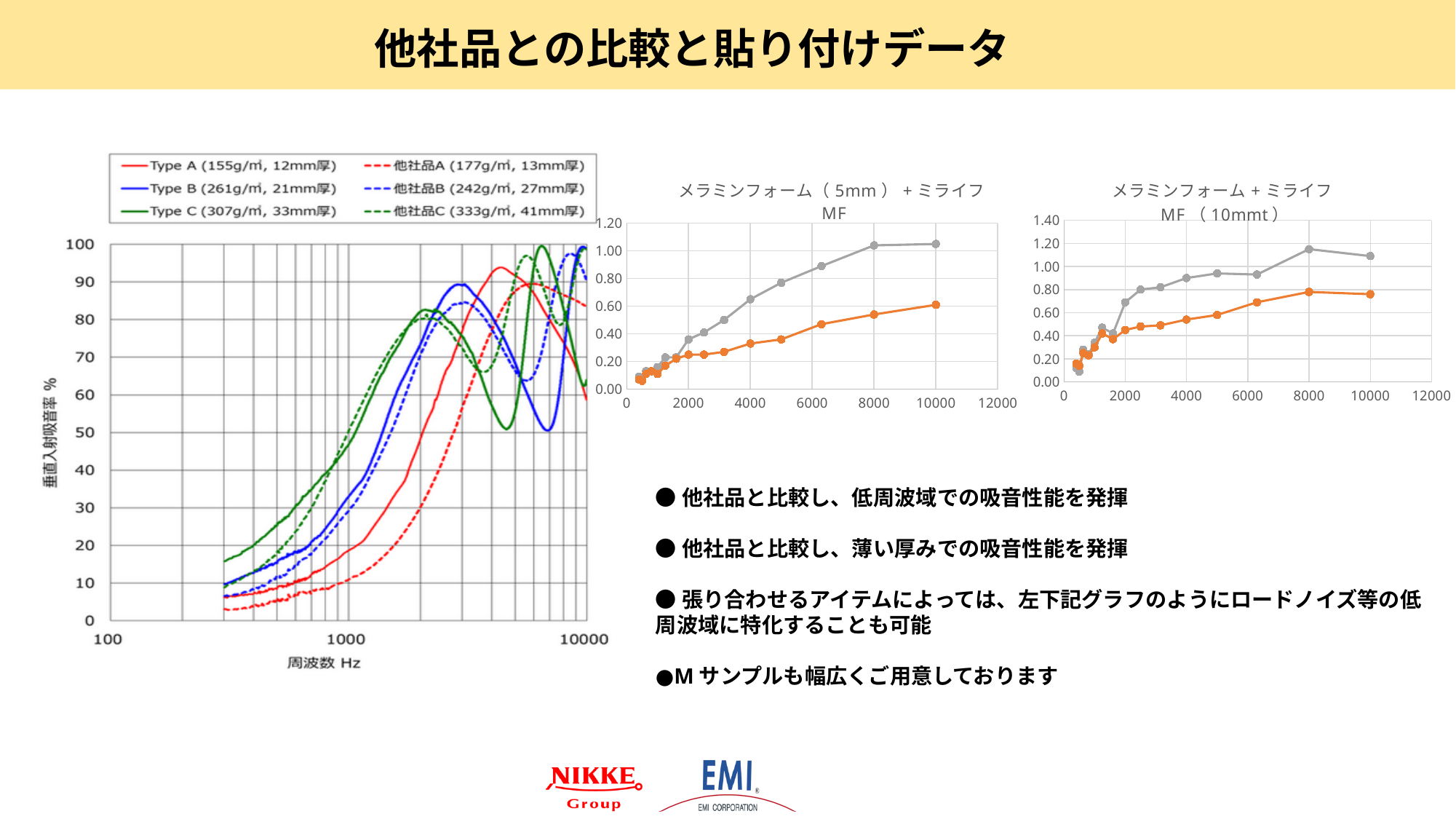
In the chart titled メラミンフォーム（5mm）+ミライフMF, is the value of the orange line at 10000 greater or less than 0.80? less How many series does the legend of the left chart list? 6 In the left chart, which series is drawn as a solid green line? Type C (307g/㎡, 33mm厚) In the chart titled メラミンフォーム（5mm）+ミライフMF, is the value of the gray line at 10000 greater or less than 1.00? greater In the chart titled メラミンフォーム+ミライフMF（10mmt）, do the values of the gray line generally rise or fall as the x axis increases? rise In the chart titled メラミンフォーム（5mm）+ミライフMF, which line has the larger value at 8000, the gray line or the orange line? the gray line In the chart titled メラミンフォーム+ミライフMF（10mmt）, is the value of the gray line at 8000 greater or less than 1.00? greater What kind of chart is the chart titled メラミンフォーム（5mm）+ミライフMF? line chart What kind of chart is the chart on the left of the slide (with the 周波数 Hz axis)? line chart